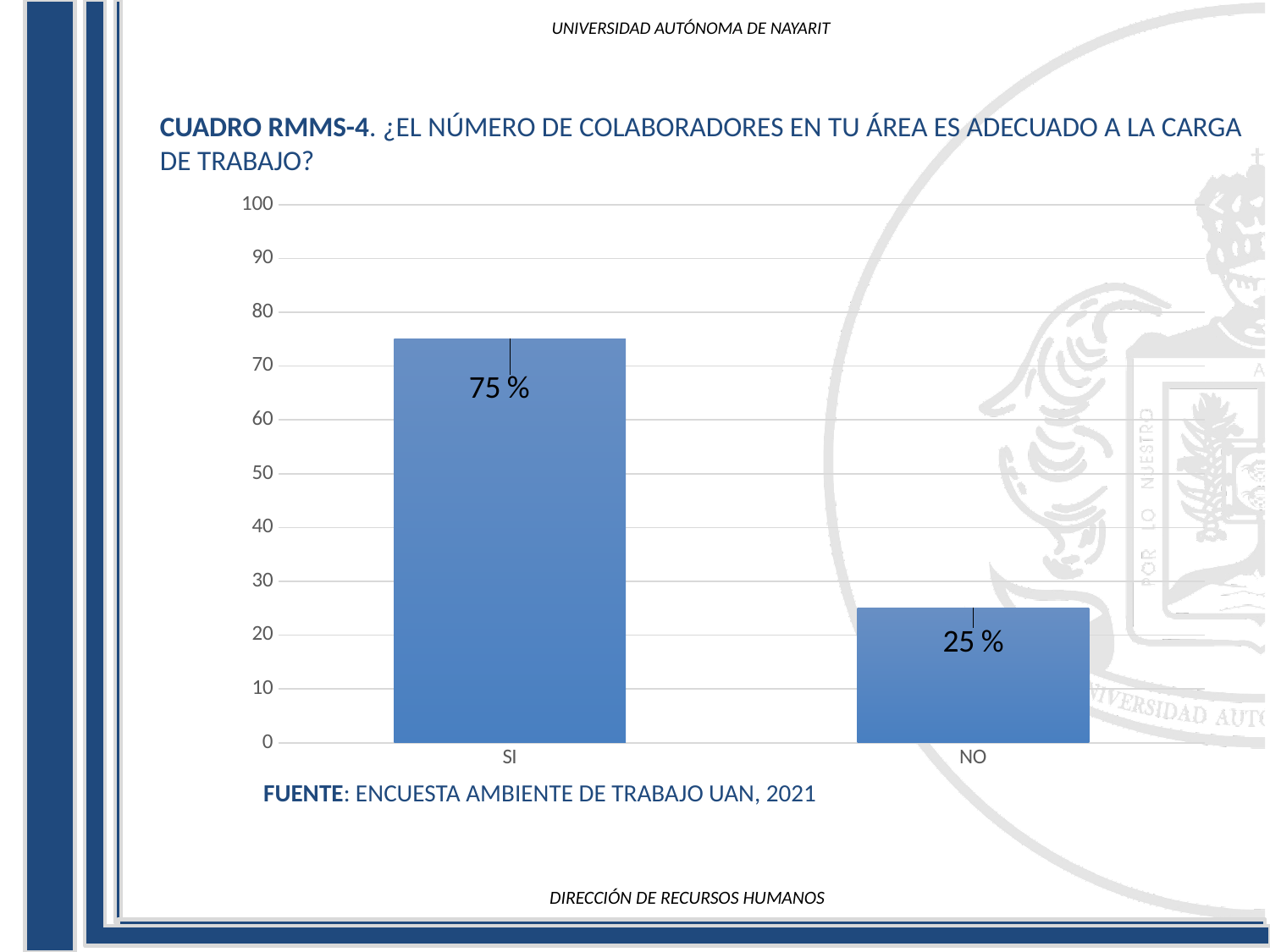
Which is larger, the value for SI or the value for NO? SI What is the value for SI? 75 % Is the value for SI greater or less than 70? greater What is the total of the values for SI and NO? 100 % How many categories are shown on the x axis? 2 Is the value for NO greater or less than 30? less What is the difference between the values for SI and NO? 50 % Which category has the highest value? SI What kind of chart is shown on the slide? bar chart What is the value for NO? 25 % What is the source cited below the chart? ENCUESTA AMBIENTE DE TRABAJO UAN, 2021 Which category has the lowest value? NO